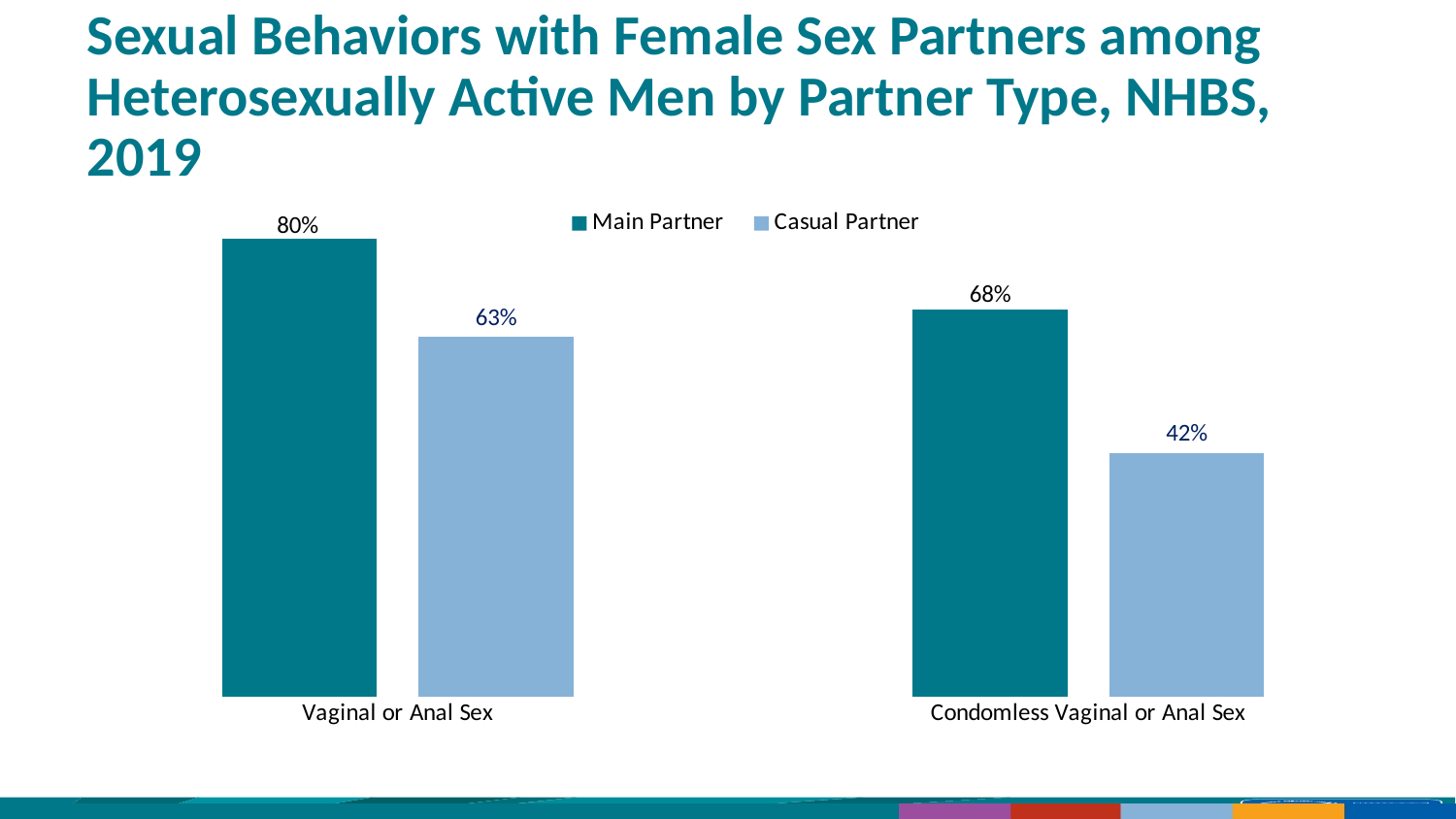
What is the difference in percentage points between main partner and casual partner for vaginal or anal sex? 17 percentage points What percentage of heterosexually active men reported condomless vaginal or anal sex with a main partner? 68% What percentage of heterosexually active men reported vaginal or anal sex with a casual partner? 63% For condomless vaginal or anal sex, which partner type has the larger value? Main Partner What is the difference in percentage points between main partner and casual partner for condomless vaginal or anal sex? 26 percentage points How many series does the legend list? 2 How many behavior categories are shown on the x axis? 2 What percentage of heterosexually active men reported vaginal or anal sex with a main partner? 80% What kind of chart is shown on the slide? Bar chart Which bar shows the lowest value on the chart? Casual Partner, Condomless Vaginal or Anal Sex Which bar shows the highest value on the chart? Main Partner, Vaginal or Anal Sex What percentage of heterosexually active men reported condomless vaginal or anal sex with a casual partner? 42%